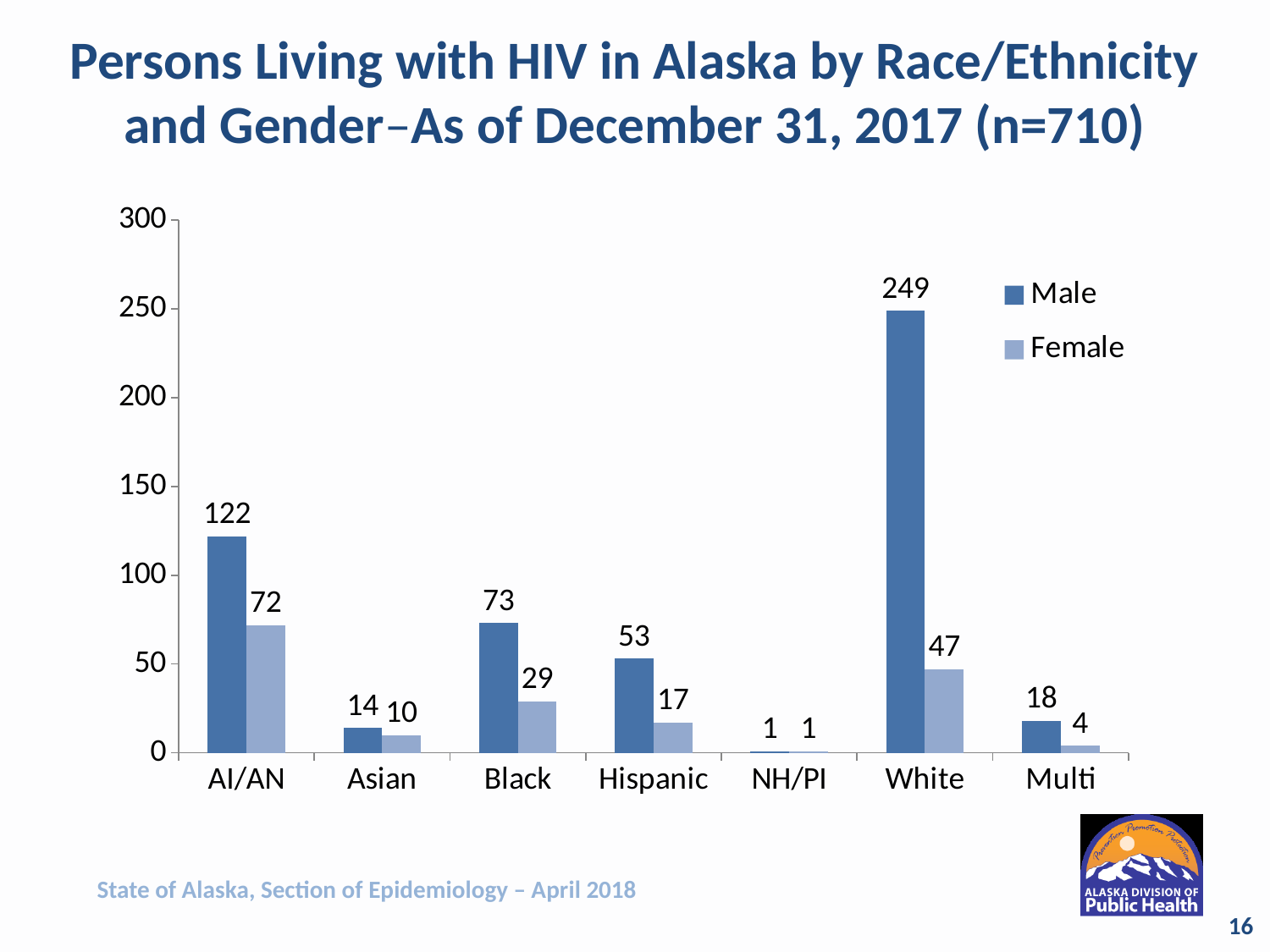
What is the Female value for Hispanic? 17 What is the combined Male and Female value for Multi? 22 Which series is shown in the darker blue colour? Male Which race/ethnicity category has the highest Male value? White How many race/ethnicity categories are shown on the x axis? 7 Which race/ethnicity category has the lowest Female value? NH/PI What is the Female value for AI/AN? 72 What is the difference between the Male and Female values for Black? 44 How many series does the legend list? 2 Which is larger, the Female value for AI/AN or the Female value for White? Female value for AI/AN What is the Male value for White? 249 What kind of chart is shown on the slide? Bar chart